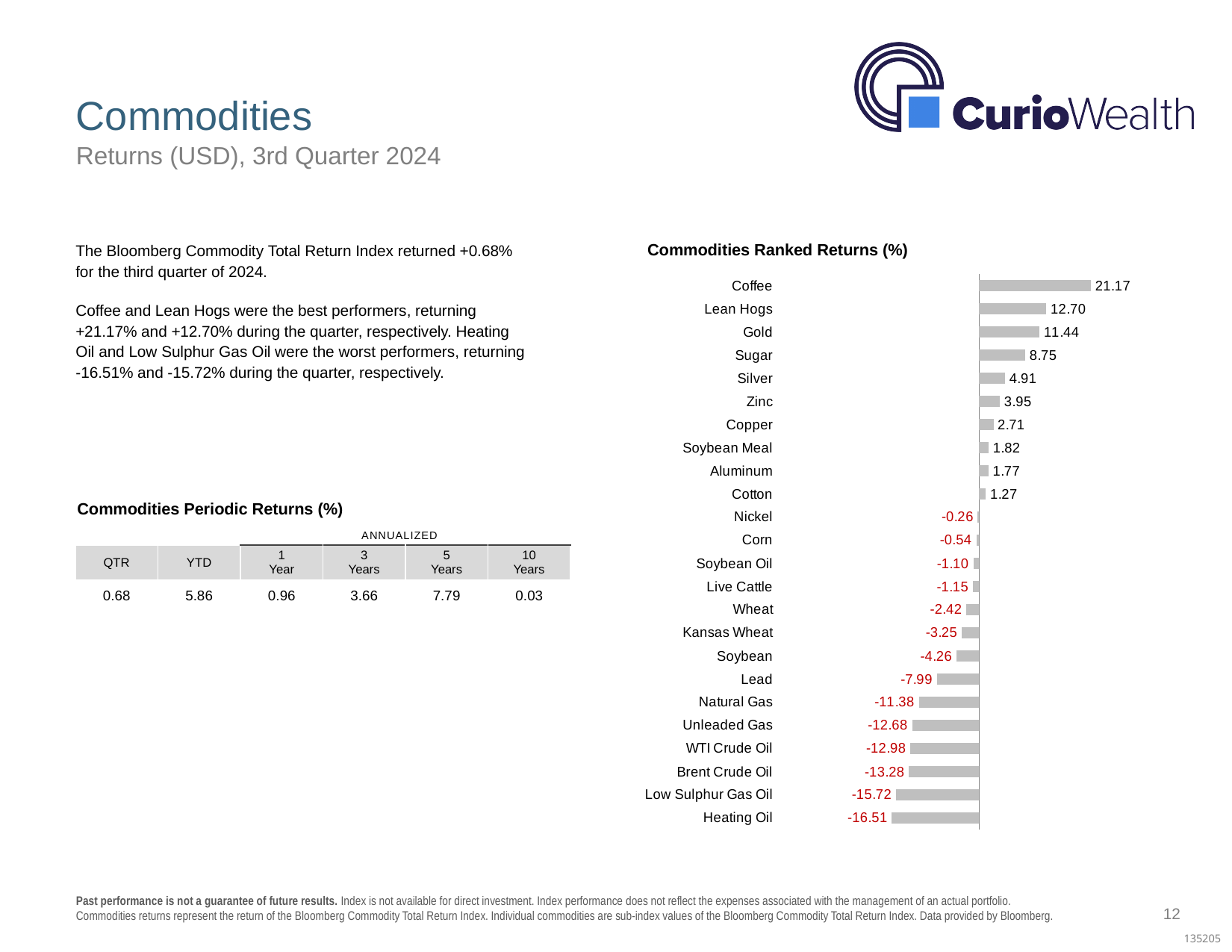
In the Commodities Ranked Returns (%) chart, what is the value for Heating Oil? -16.51 In the Commodities Ranked Returns (%) chart, do the values rise or fall going from the top bar to the bottom bar? Fall In the Commodities Ranked Returns (%) chart, what is the value for Coffee? 21.17 What kind of chart is the Commodities Ranked Returns (%) chart? Bar chart In the Commodities Ranked Returns (%) chart, what is the difference between the values for Gold and Sugar? 2.69 In the Commodities Ranked Returns (%) chart, which is larger, the value for Zinc or the value for Copper? Zinc In the Commodities Ranked Returns (%) chart, what is the value for Natural Gas? -11.38 In the Commodities Ranked Returns (%) chart, what is the difference between the values for Coffee and Lean Hogs? 8.47 In the Commodities Ranked Returns (%) chart, what is the value for Silver? 4.91 How many commodities are shown in the Commodities Ranked Returns (%) chart? 24 Which commodity has the lowest return in the Commodities Ranked Returns (%) chart? Heating Oil Which commodity has the highest return in the Commodities Ranked Returns (%) chart? Coffee